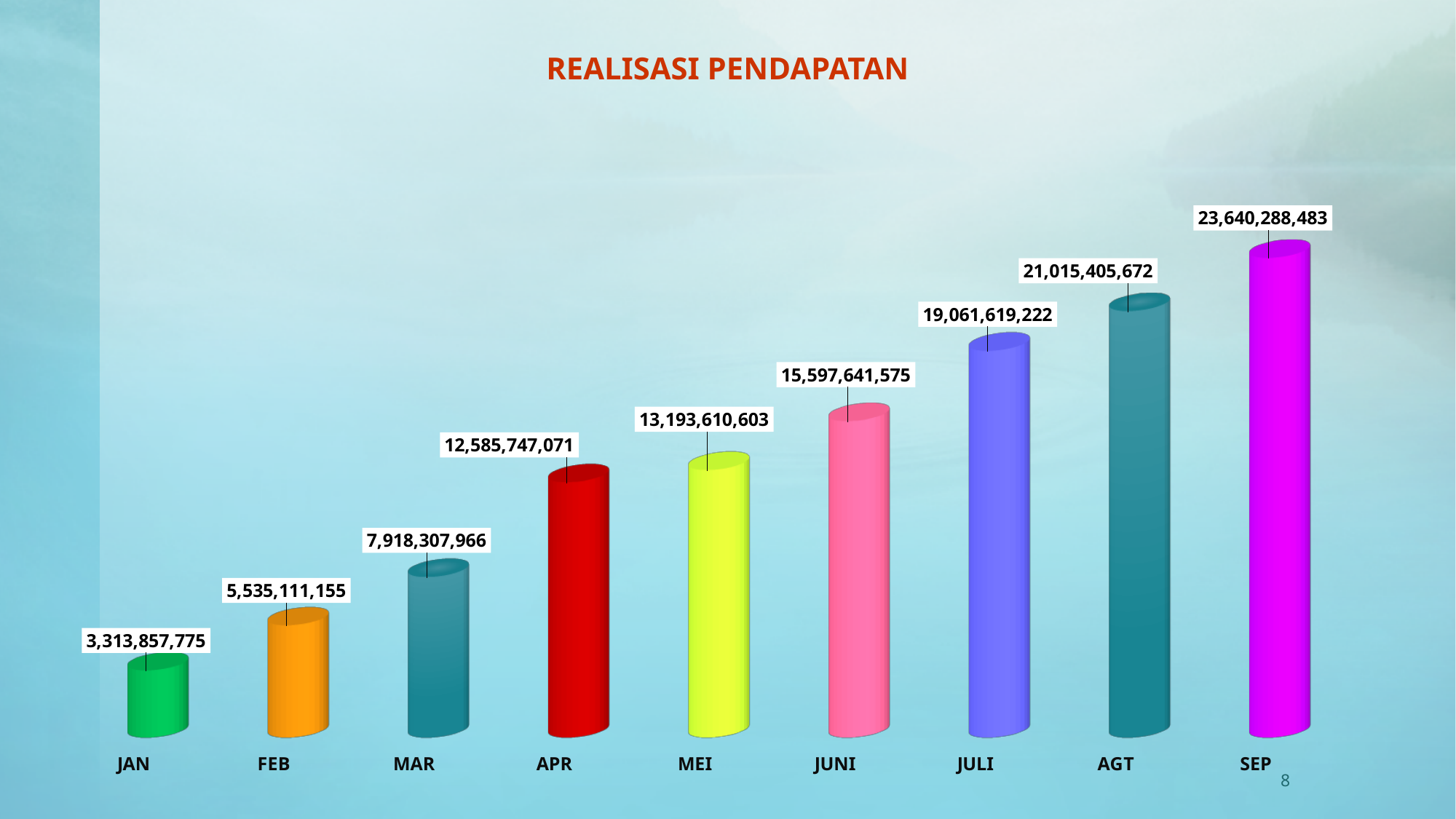
What is the value for JULI? 19,061,619,222 What is the title of the chart? REALISASI PENDAPATAN What is the value for JAN? 3,313,857,775 Which month has the lowest value? JAN What is the value for APR? 12,585,747,071 What kind of chart is shown on the slide? Bar chart Which month has the highest value? SEP Which is larger, the value for MEI or the value for JUNI? JUNI What is the difference between the values for FEB and JAN? 2,221,253,380 Do the values rise or fall from JAN to SEP? Rise What is the difference between the values for SEP and AGT? 2,624,882,811 How many months are shown on the chart? 9